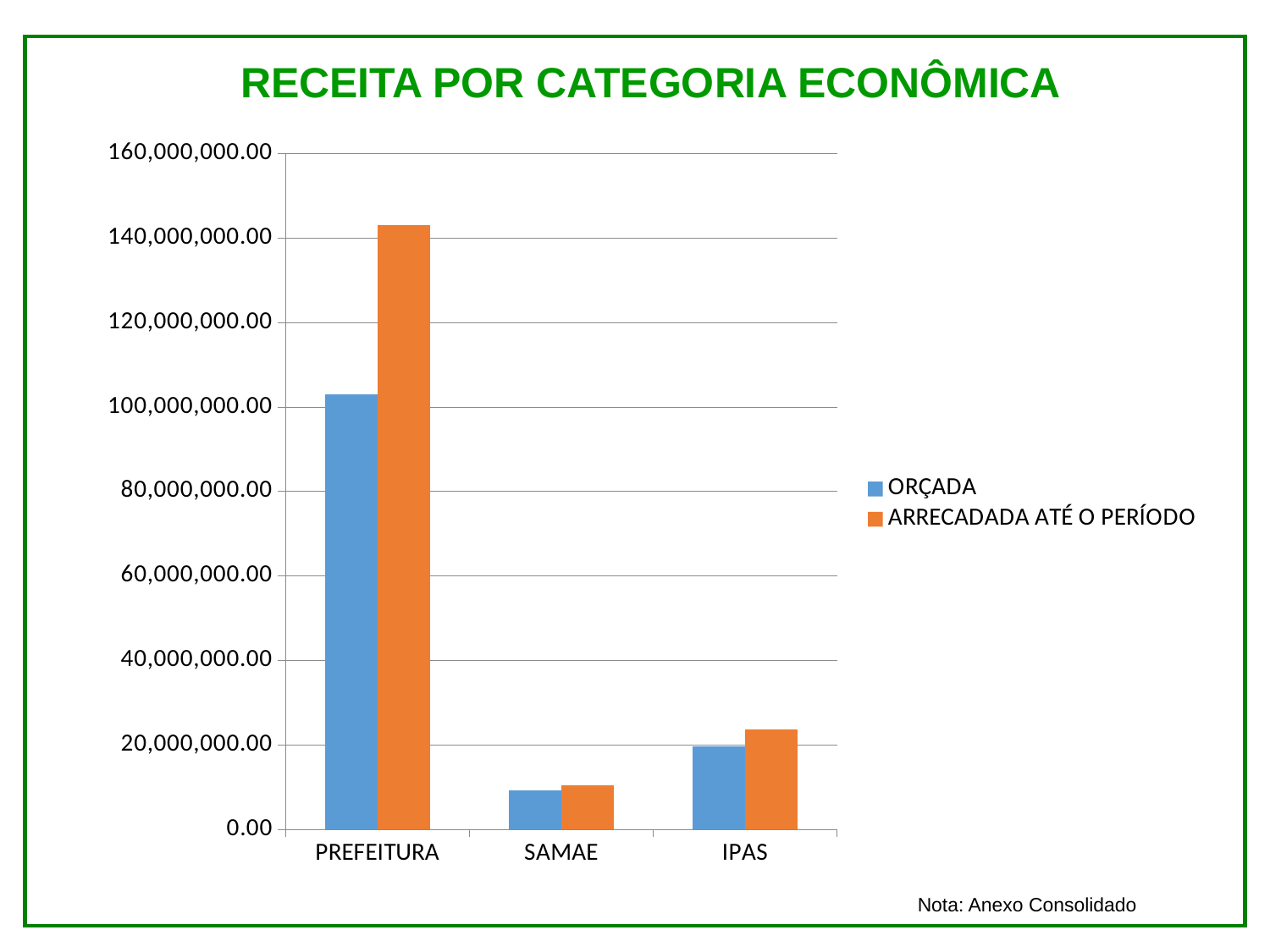
Is the ORÇADA value for SAMAE greater or less than 20,000,000.00? less Which category has the highest ARRECADADA ATÉ O PERÍODO value? PREFEITURA For PREFEITURA, which is larger: ORÇADA or ARRECADADA ATÉ O PERÍODO? ARRECADADA ATÉ O PERÍODO What is the title of the chart? RECEITA POR CATEGORIA ECONÔMICA For IPAS, which is larger: ORÇADA or ARRECADADA ATÉ O PERÍODO? ARRECADADA ATÉ O PERÍODO How many series does the legend list? 2 How many categories are shown on the x axis? 3 Which colour represents the ORÇADA series in the legend? blue Is the ARRECADADA ATÉ O PERÍODO value for PREFEITURA greater or less than 140,000,000.00? greater Which category has the lowest ORÇADA value? SAMAE Is the ARRECADADA ATÉ O PERÍODO value for IPAS greater or less than 20,000,000.00? greater What type of chart is shown on the slide? bar chart